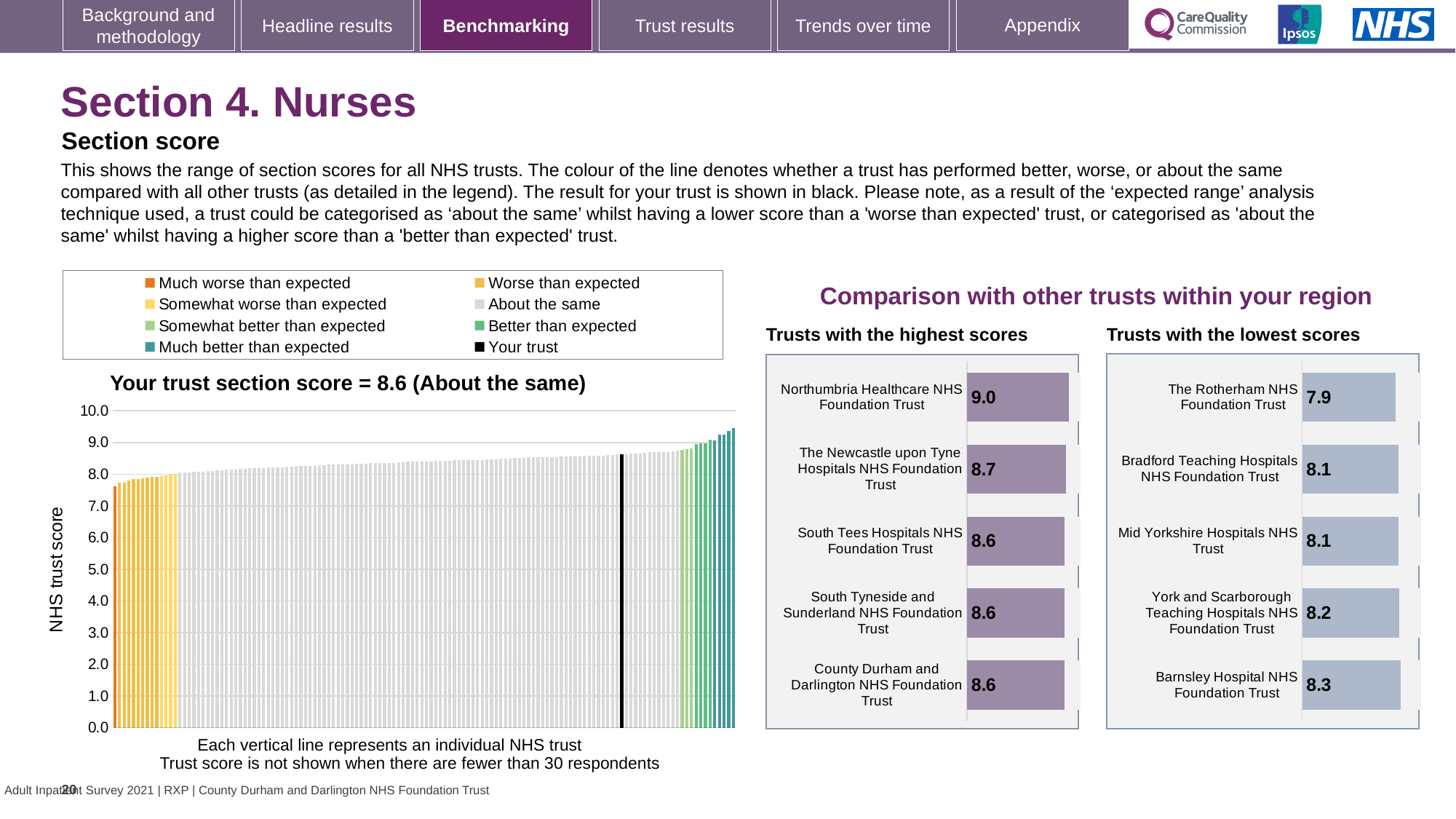
In the 'Trusts with the highest scores' chart, what is the score for Northumbria Healthcare NHS Foundation Trust? 9.0 In the 'Trusts with the lowest scores' chart, what is the difference between the scores of Barnsley Hospital NHS Foundation Trust and The Rotherham NHS Foundation Trust? 0.4 In the 'Trusts with the lowest scores' chart, which trust has the highest score? Barnsley Hospital NHS Foundation Trust In the 'Your trust section score' chart, do the bar values rise or fall from left to right? rise In the 'Trusts with the highest scores' chart, which trust has the highest score? Northumbria Healthcare NHS Foundation Trust How many entries does the legend above the 'Your trust section score' chart list? 8 In the 'Trusts with the lowest scores' chart, which trust has the lowest score? The Rotherham NHS Foundation Trust In the 'Trusts with the lowest scores' chart, what is the score for The Rotherham NHS Foundation Trust? 7.9 In the 'Trusts with the highest scores' chart, what is the difference between the scores of Northumbria Healthcare NHS Foundation Trust and The Newcastle upon Tyne Hospitals NHS Foundation Trust? 0.3 How many trusts are listed in the 'Trusts with the lowest scores' chart? 5 In the 'Your trust section score' chart, what is the section score for your trust? 8.6 In the 'Trusts with the highest scores' chart, what is the score for The Newcastle upon Tyne Hospitals NHS Foundation Trust? 8.7